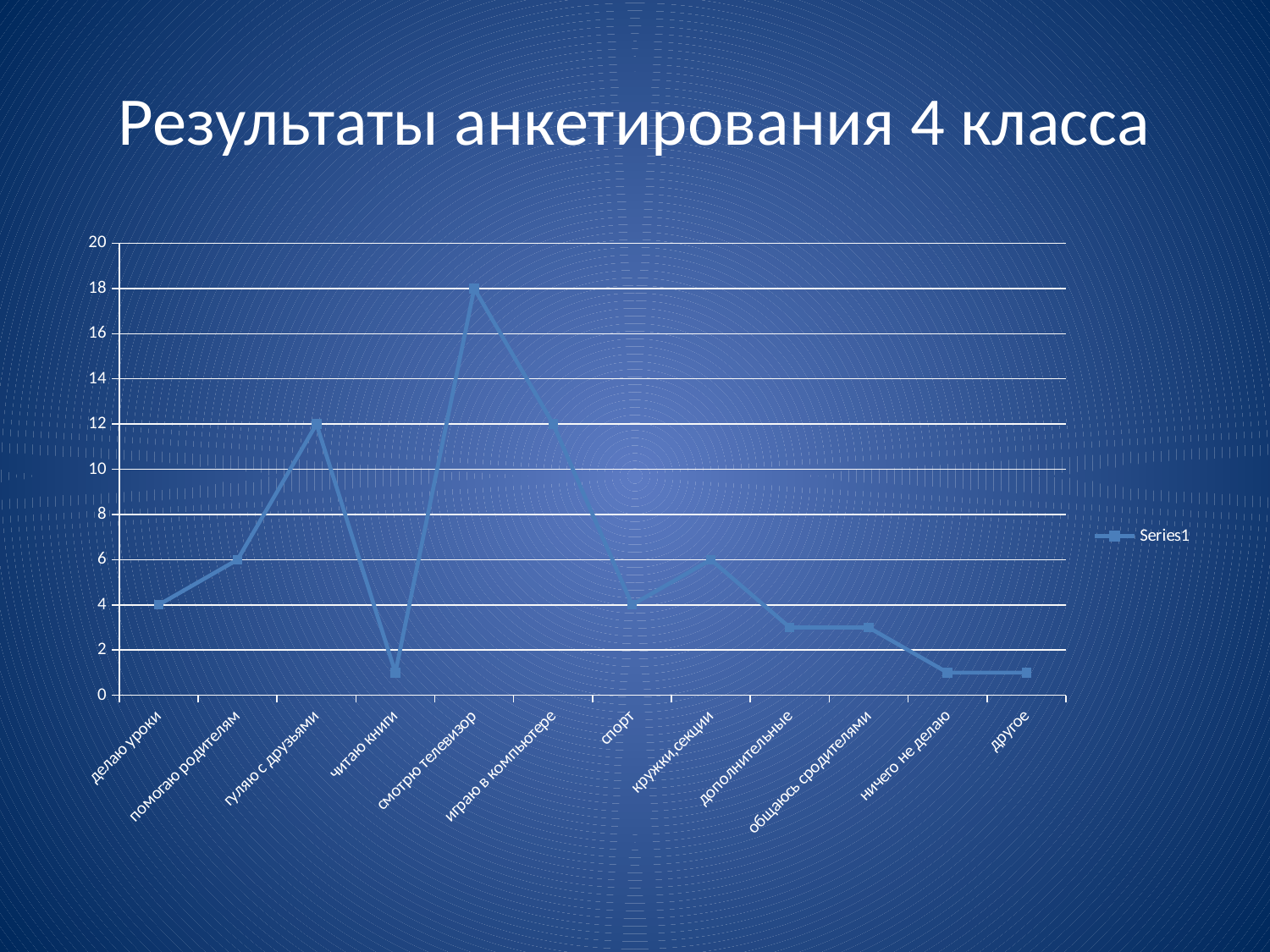
How many series does the legend list? 1 Is the value for "дополнительные" greater or less than 4? less What is the value for "смотрю телевизор"? 18 Which category has the highest value? смотрю телевизор How many categories are plotted along the x axis? 12 What is the value for "гуляю с друзьями"? 12 Which is larger, the value for "гуляю с друзьями" or the value for "помогаю родителям"? гуляю с друзьями What kind of chart is shown on the slide? line chart Is the value for "читаю книги" greater or less than 2? less What is the title of the slide? Результаты анкетирования 4 класса What is the difference between the values for "смотрю телевизор" and "играю в компьютере"? 6 What is the value for "делаю уроки"? 4